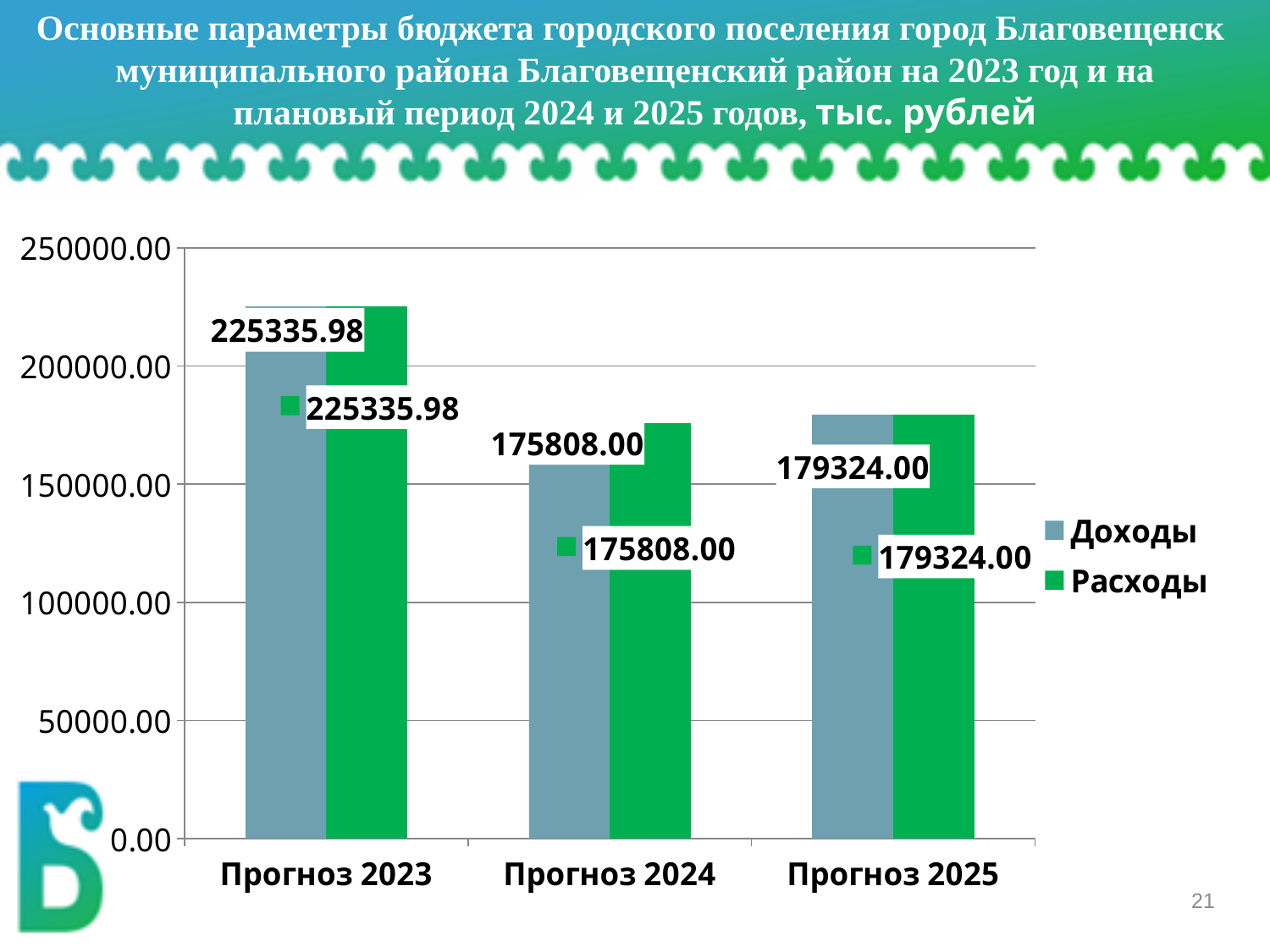
Which category has the highest Расходы value? Прогноз 2023 What is the difference between the Расходы values for Прогноз 2025 and Прогноз 2024? 3516.00 What is the value of Расходы for Прогноз 2025? 179324.00 What is the value of Расходы for Прогноз 2023? 225335.98 Which is larger: Расходы for Прогноз 2023 or Расходы for Прогноз 2025? Прогноз 2023 How many series does the legend list? 2 How many categories are shown on the x axis? 3 What is the value of Доходы for Прогноз 2024? 175808.00 What is the value of Расходы for Прогноз 2024? 175808.00 Is the Расходы value for Прогноз 2023 greater or less than 200000.00? greater What is the difference between the Расходы values for Прогноз 2023 and Прогноз 2024? 49527.98 Which category has the lowest Расходы value? Прогноз 2024